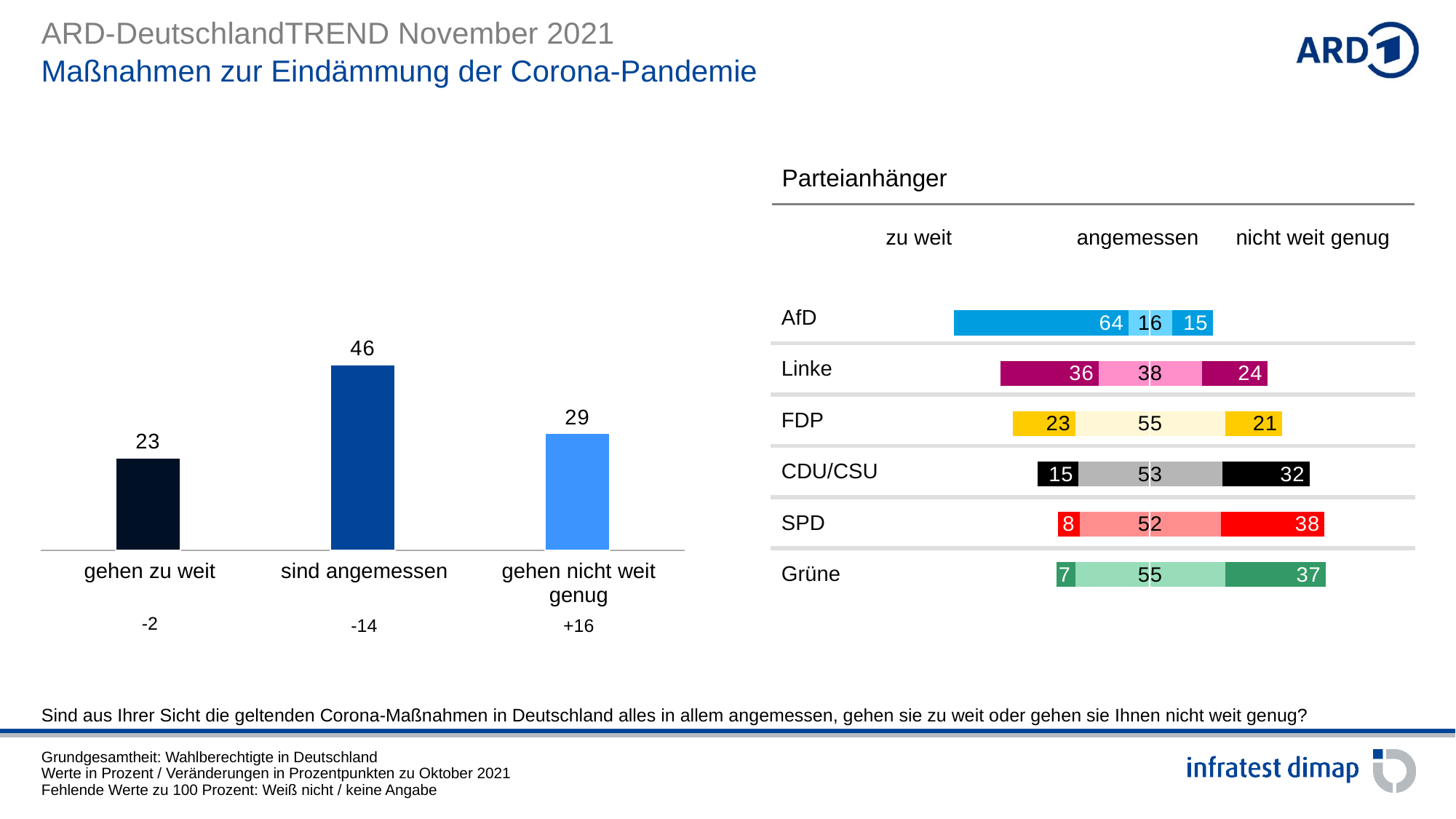
In the Parteianhänger chart, what is the "zu weit" value for AfD? 64 In the Parteianhänger chart, which party has the lowest "zu weit" value? Grüne In the Parteianhänger chart, how many parties are listed? 6 In the left bar chart, which category has the lowest value? gehen zu weit What kind of chart is the left chart? bar chart In the Parteianhänger chart, is the "angemessen" value larger for FDP or for Linke? FDP In the Parteianhänger chart, what is the total of the three segments for CDU/CSU? 100 In the Parteianhänger chart, which party has the highest "zu weit" value? AfD In the Parteianhänger chart, what is the "nicht weit genug" value for SPD? 38 In the left bar chart, what is the difference between "sind angemessen" and "gehen nicht weit genug"? 17 In the left bar chart, what is the value for "sind angemessen"? 46 In the left bar chart, how many categories are shown? 3